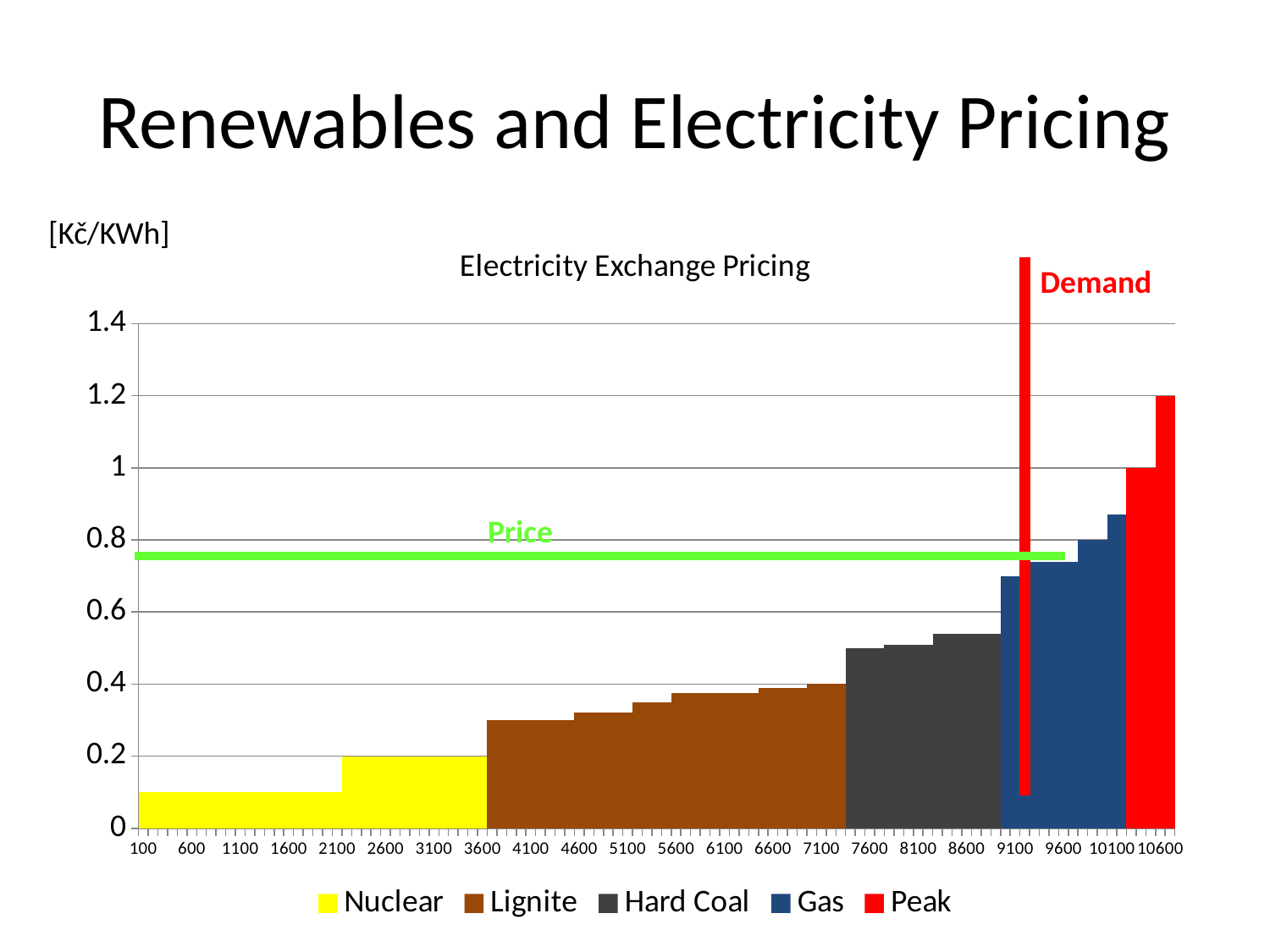
What unit is shown for the values on the chart? [Kč/KWh] What is the title of the chart? Electricity Exchange Pricing How many series does the legend list? 5 Is the value at 9600 greater or less than 0.6? greater Which is larger, the value at 5100 or the value at 7600? 7600 Do the bar values rise or fall moving from left to right along the x axis? rise Is the value at 4100 greater or less than 0.4? less Which series has the lowest values on the chart? Nuclear What kind of chart is shown on the slide? bar chart Which series has the highest values on the chart? Peak Is the value at 8600 greater or less than 0.6? less